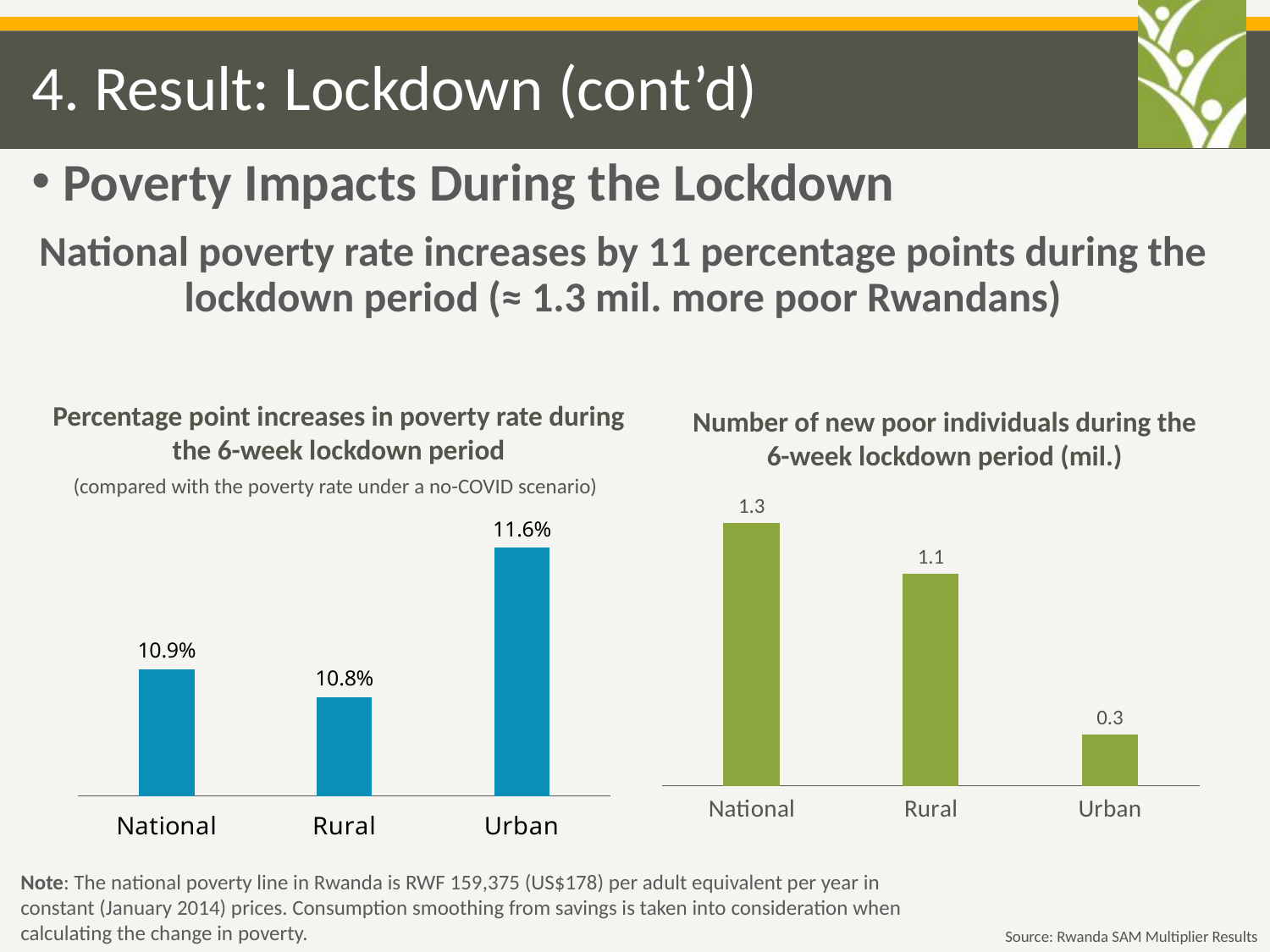
In the 'Number of new poor individuals during the 6-week lockdown period (mil.)' chart, which category has the lowest value? Urban In the 'Percentage point increases in poverty rate during the 6-week lockdown period' chart, which category has the lowest value? Rural In the 'Percentage point increases in poverty rate during the 6-week lockdown period' chart, what is the value for Rural? 10.8% In the 'Number of new poor individuals during the 6-week lockdown period (mil.)' chart, what is the difference between the Rural and Urban values? 0.8 What type of chart is the 'Percentage point increases in poverty rate during the 6-week lockdown period' chart? Bar chart In the 'Number of new poor individuals during the 6-week lockdown period (mil.)' chart, what is the value for Urban? 0.3 In the 'Percentage point increases in poverty rate during the 6-week lockdown period' chart, which category has the highest value? Urban In the 'Percentage point increases in poverty rate during the 6-week lockdown period' chart, what is the value for Urban? 11.6% In the 'Number of new poor individuals during the 6-week lockdown period (mil.)' chart, what is the value for National? 1.3 In the 'Number of new poor individuals during the 6-week lockdown period (mil.)' chart, which is larger, National or Rural? National In the 'Percentage point increases in poverty rate during the 6-week lockdown period' chart, what is the difference between the Urban and National values? 0.7 percentage points How many categories are shown in the 'Number of new poor individuals during the 6-week lockdown period (mil.)' chart? 3